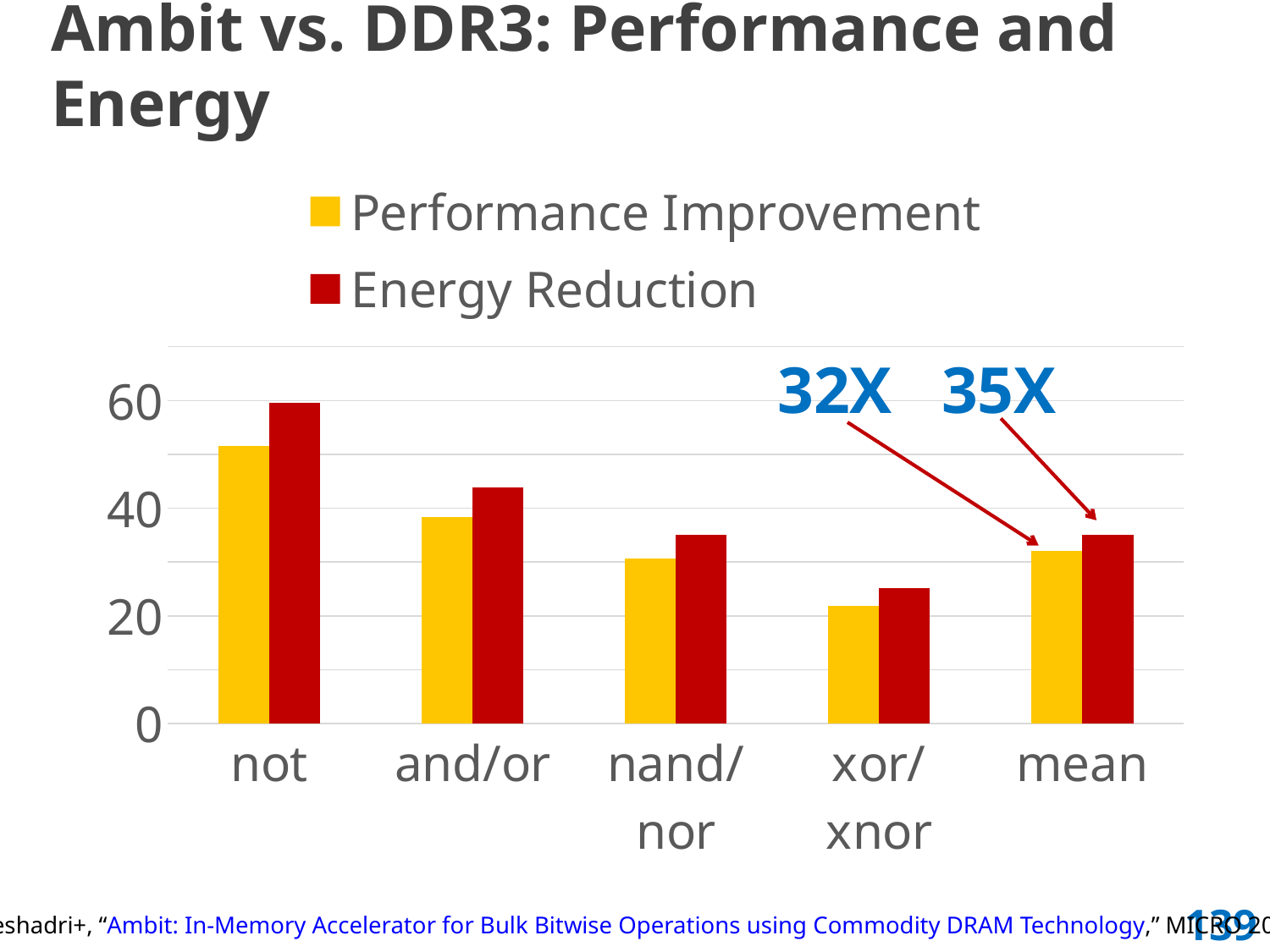
What is the difference between the Energy Reduction and Performance Improvement values for the mean category? 3X Do the Performance Improvement values rise or fall going from not to xor/xnor? fall What kind of chart is shown on the slide? bar chart Which category has the highest Performance Improvement? not Is the Energy Reduction value for not greater or less than 40? greater How many series does the legend list? 2 Is the Performance Improvement value for xor/xnor greater or less than 40? less For the not category, which is larger: Performance Improvement or Energy Reduction? Energy Reduction What is the Energy Reduction value for the mean category? 35X How many categories are shown along the x axis? 5 Which category has the lowest Energy Reduction? xor/xnor What is the Performance Improvement value for the mean category? 32X